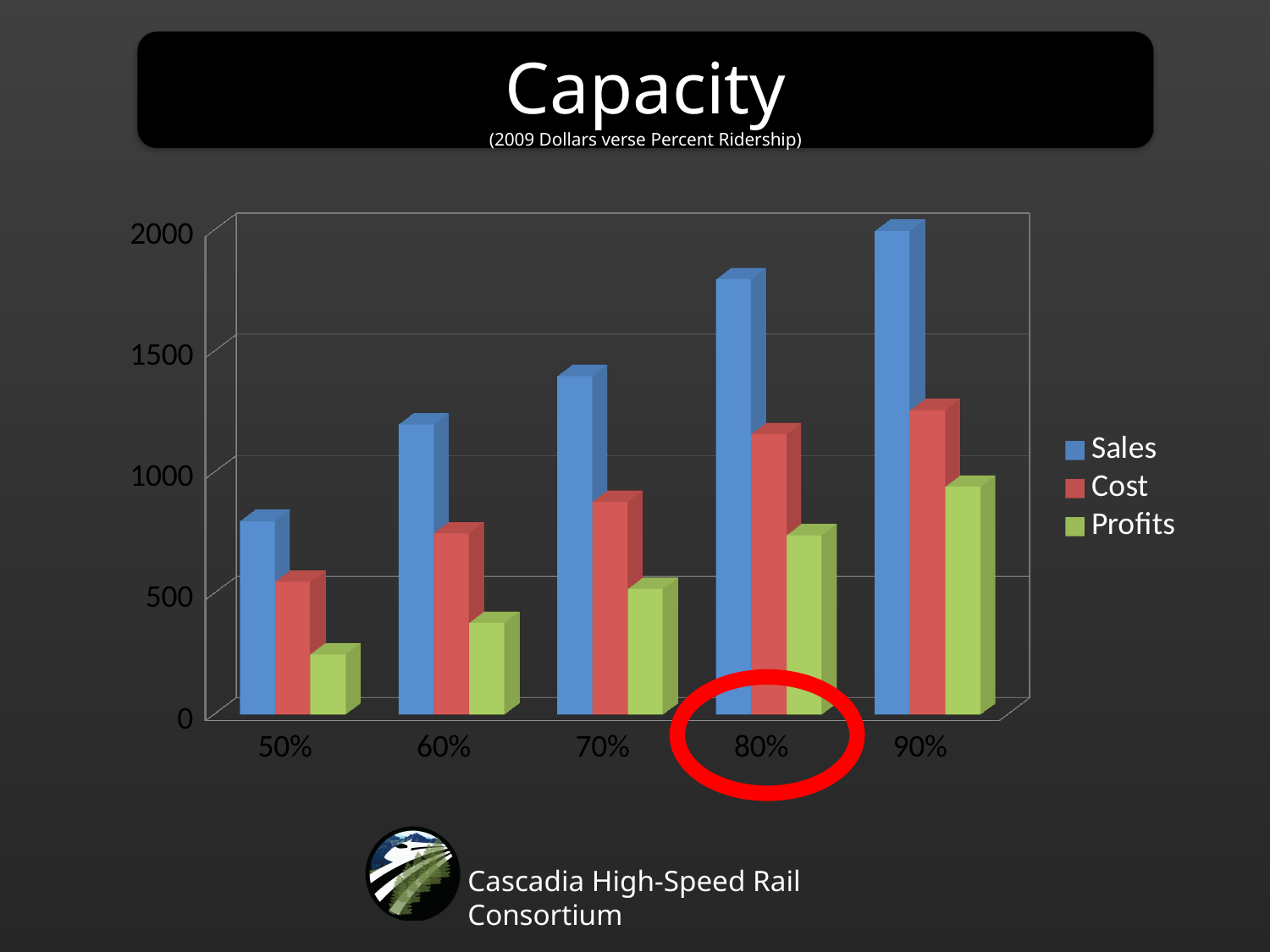
At which ridership percentage is Profits lowest? 50% Is the Sales value at 80% ridership greater or less than 1500? greater At which ridership percentage is Sales highest? 90% Is the Sales value at 70% ridership greater or less than 1500? less At 80% ridership, which is larger, Sales or Cost? Sales Which x-axis category is circled in red on the slide? 80% How many series does the legend list? 3 Is the Cost value at 90% ridership greater or less than 1000? greater Do the Sales values rise or fall as ridership increases from 50% to 90%? rise How many ridership percentage categories are shown on the x axis? 5 What kind of chart is shown on the slide? bar chart